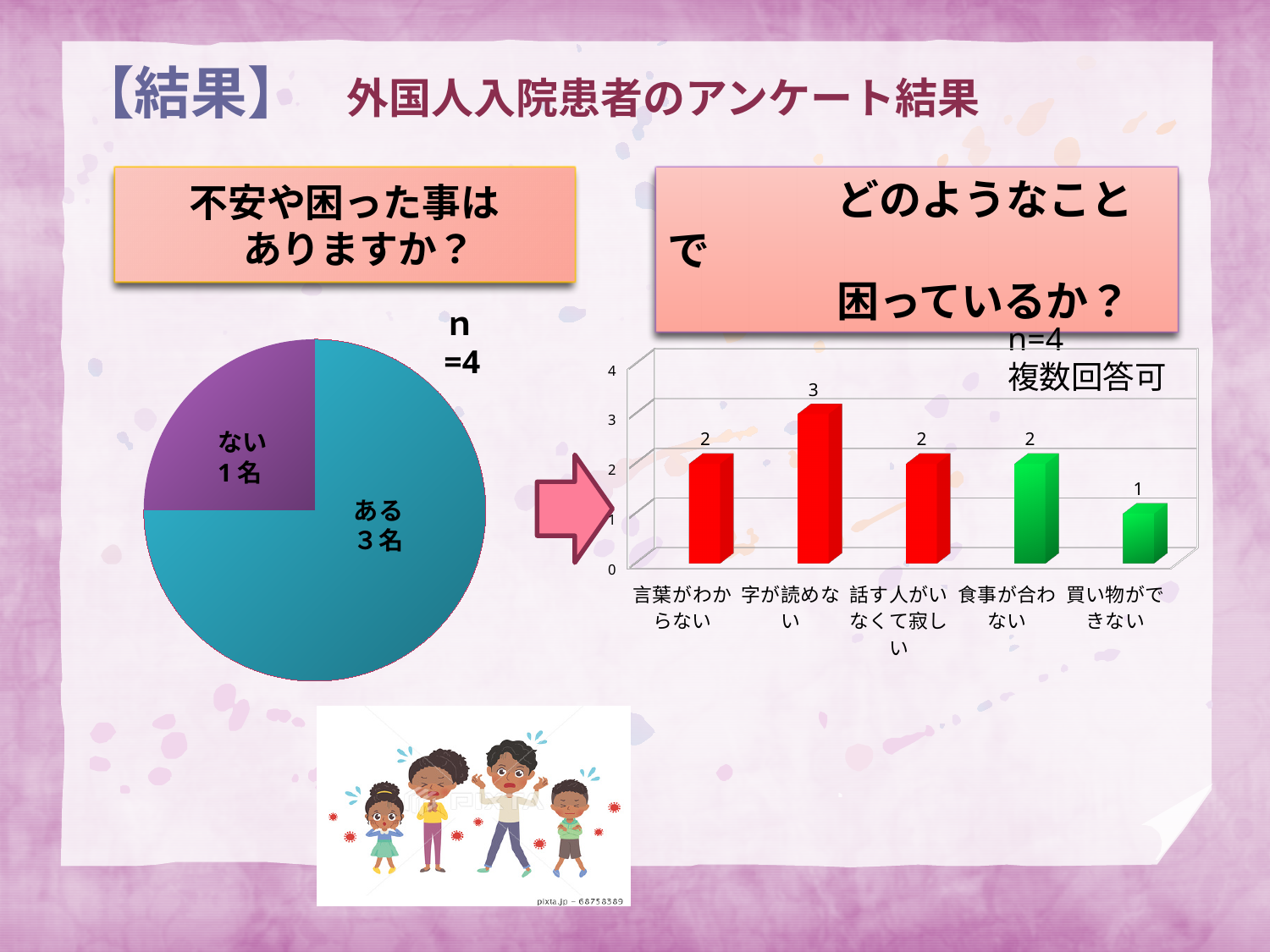
In the bar chart on the right, what is the value for 字が読めない? 3 In the bar chart on the right, how many categories are shown? 5 In the bar chart on the right, which category has the lowest value? 買い物ができない What type of chart is the chart on the left of the slide? Pie chart In the bar chart on the right, what is the difference between the values for 字が読めない and 買い物ができない? 2 In the pie chart on the left, which answer has the larger slice, ある or ない? ある What type of chart is the chart on the right of the slide? Bar chart In the pie chart on the left, how many respondents answered ある? 3名 In the bar chart on the right, what is the value for 買い物ができない? 1 In the pie chart on the left, how many slices are there? 2 In the pie chart on the left, how many respondents answered ない? 1名 In the bar chart on the right, which category has the highest value? 字が読めない